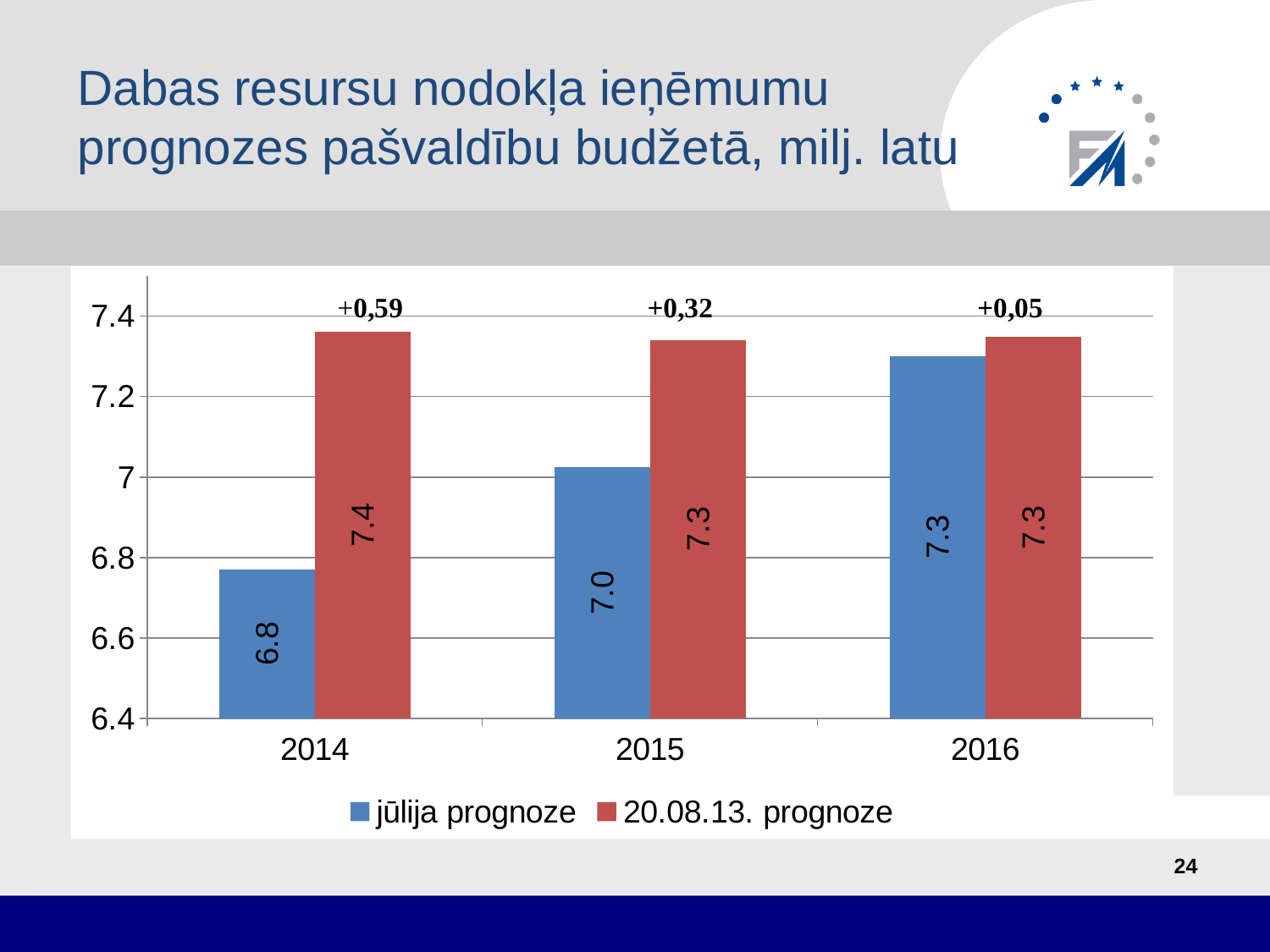
In which year is the jūlija prognoze the lowest? 2014 How many years are shown on the x axis? 3 In which year is the jūlija prognoze the highest? 2016 What is the value of the jūlija prognoze for 2015? 7.0 What is the value of the 20.08.13. prognoze for 2014? 7.4 Does the jūlija prognoze rise or fall from 2014 to 2016? rise What type of chart is shown on the slide? bar chart For 2014, which is larger: the jūlija prognoze or the 20.08.13. prognoze? 20.08.13. prognoze Is the jūlija prognoze for 2014 greater or less than 7? less What is the value of the jūlija prognoze for 2014? 6.8 What is the value of the 20.08.13. prognoze for 2016? 7.3 How many series does the legend list? 2